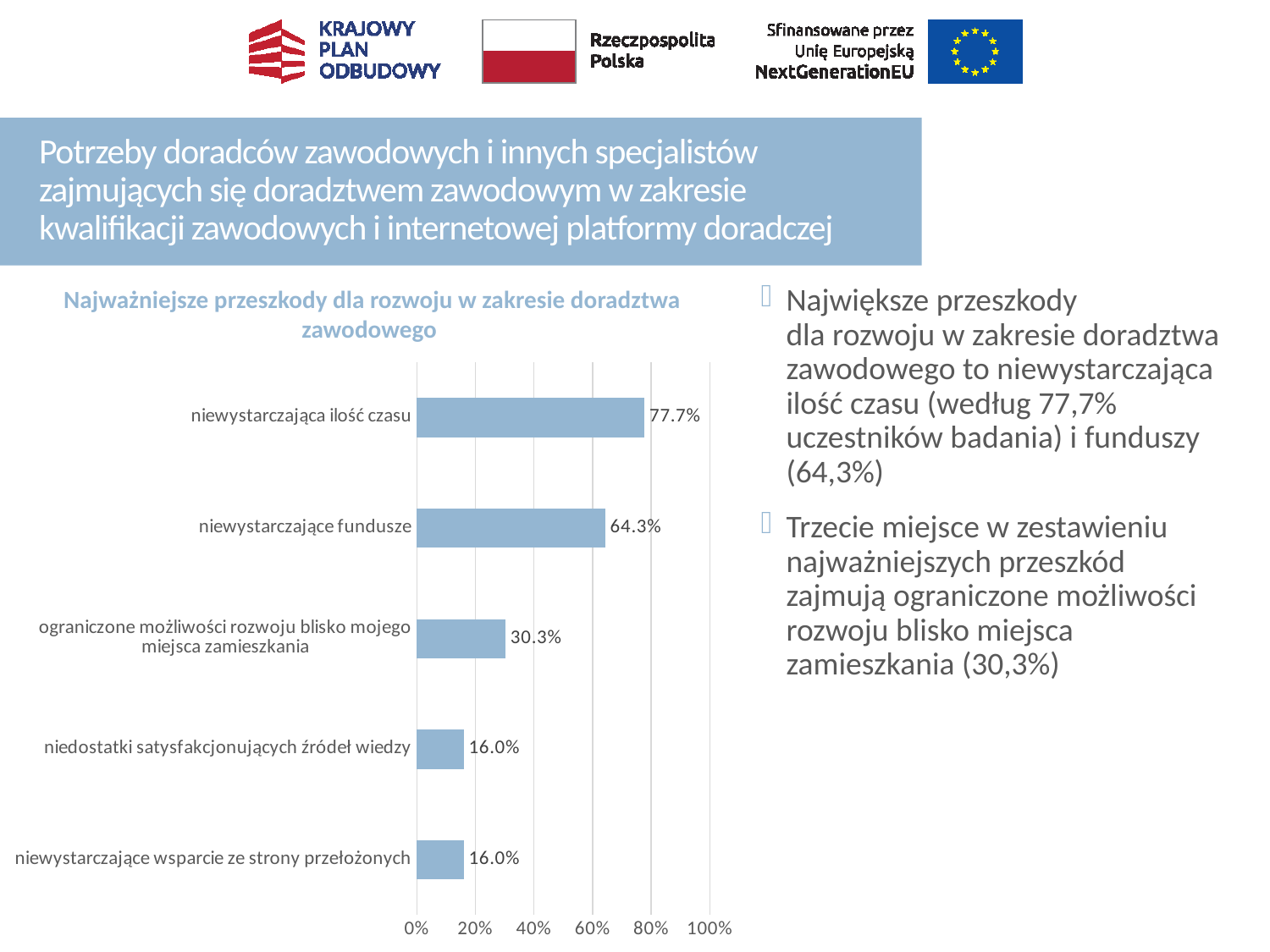
Which category has the highest value? niewystarczająca ilość czasu What is the difference between the values for "ograniczone możliwości rozwoju blisko mojego miejsca zamieszkania" and "niewystarczające wsparcie ze strony przełożonych"? 14.3% What is the value for "ograniczone możliwości rozwoju blisko mojego miejsca zamieszkania"? 30.3% What kind of chart is shown on the slide? bar chart What is the difference between the values for "niewystarczająca ilość czasu" and "niewystarczające fundusze"? 13.4% What is the value for "niewystarczające fundusze"? 64.3% Which is larger, the value for "niewystarczające fundusze" or the value for "ograniczone możliwości rozwoju blisko mojego miejsca zamieszkania"? niewystarczające fundusze Is the value for "niewystarczające fundusze" greater or less than 60%? greater What is the value for "niewystarczająca ilość czasu"? 77.7% What is the title of the chart? Najważniejsze przeszkody dla rozwoju w zakresie doradztwa zawodowego What is the value for "niedostatki satysfakcjonujących źródeł wiedzy"? 16.0% How many categories are shown in the chart? 5